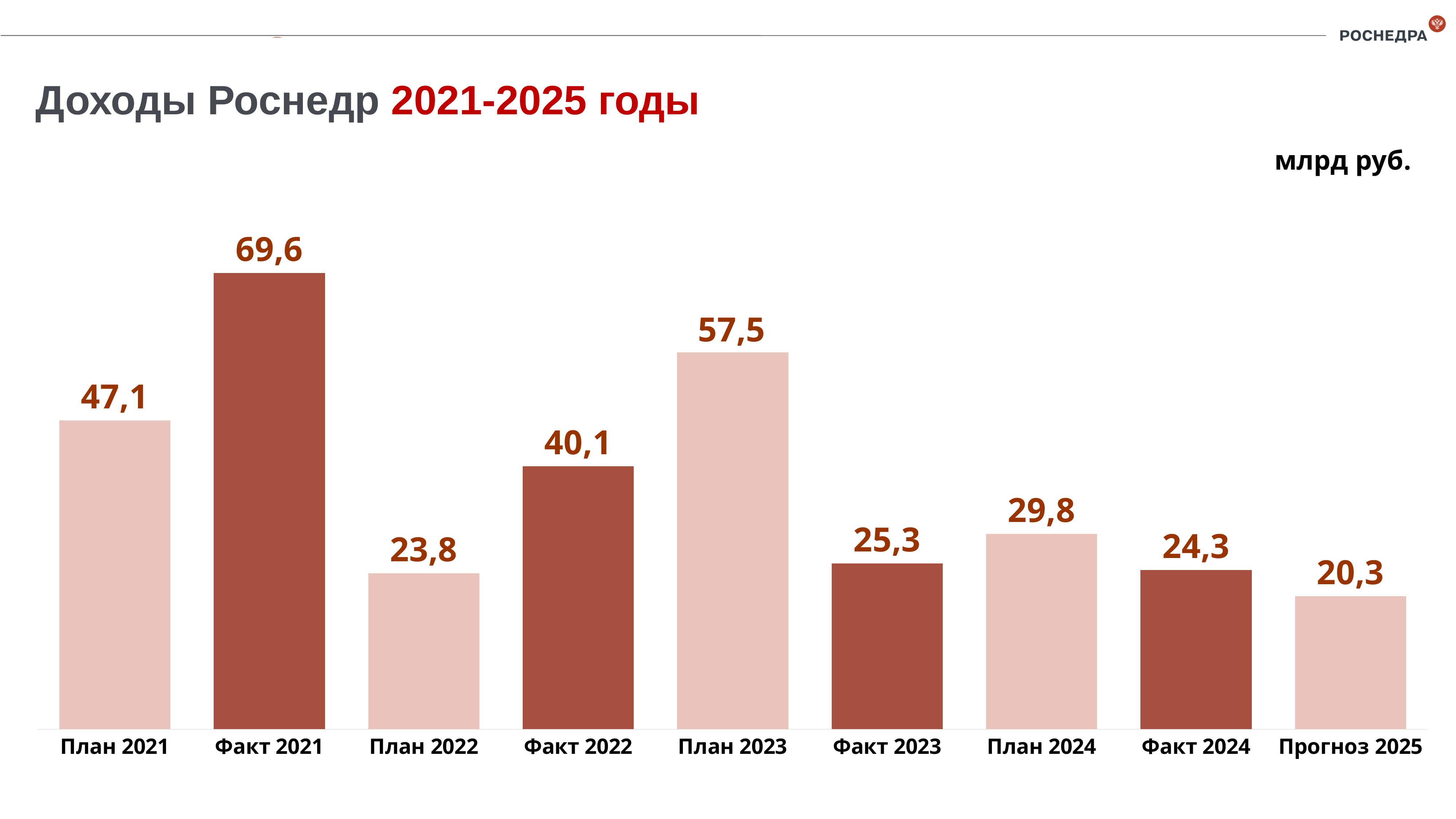
What is the value for План 2023? 57,5 What is the value for Факт 2024? 24,3 Which category has the lowest value? Прогноз 2025 What unit is indicated for the values in the chart? млрд руб. Which is larger, Факт 2022 or План 2022? Факт 2022 What is the difference between План 2023 and Факт 2023? 32,2 What is the value for Прогноз 2025? 20,3 What is the difference between Факт 2021 and План 2021? 22,5 What kind of chart is shown on the slide? Bar chart How many bars are shown in the chart? 9 What is the value for Факт 2021? 69,6 Which category has the highest value? Факт 2021